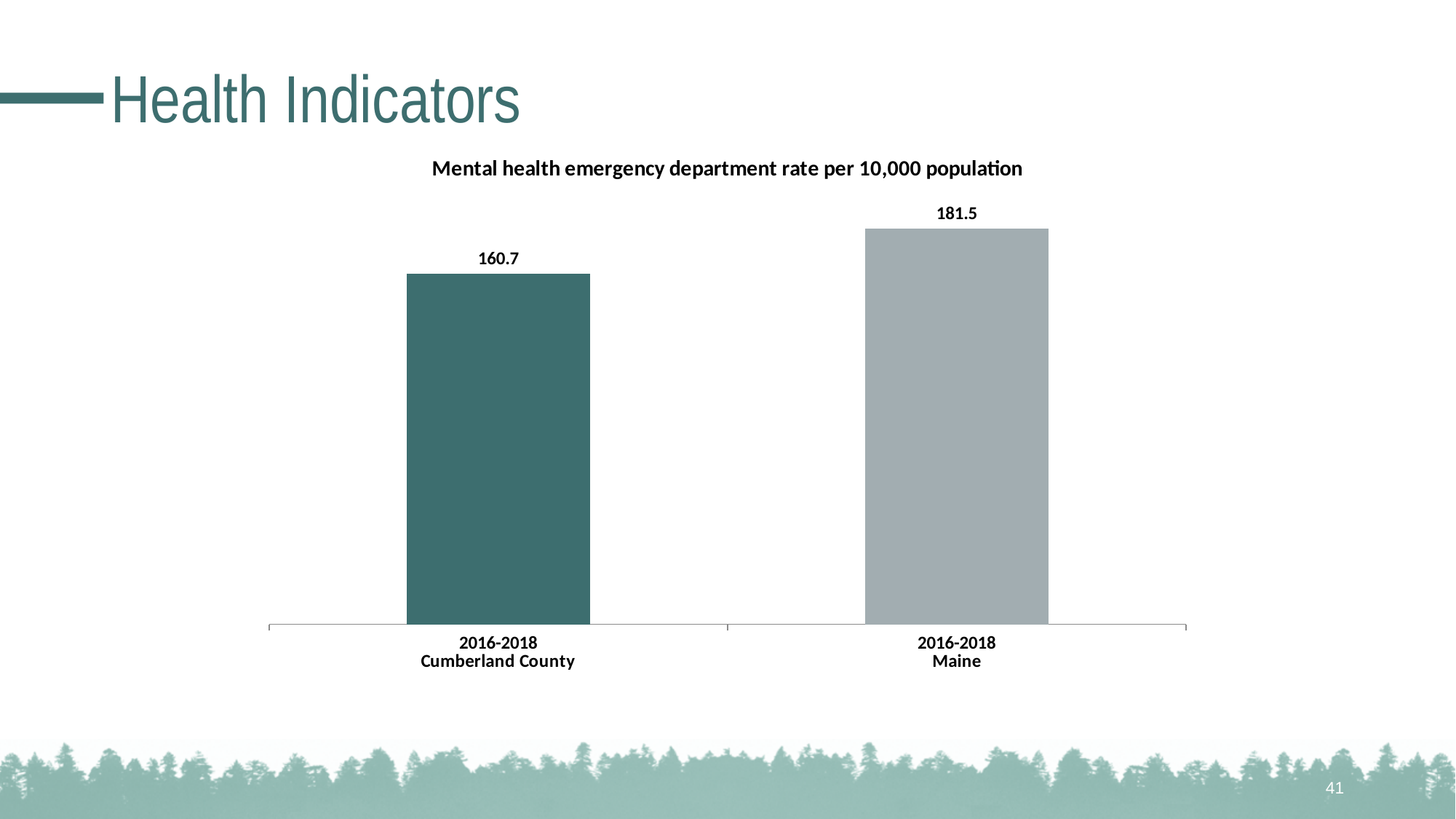
What is the mental health emergency department rate per 10,000 population for Maine (2016-2018)? 181.5 Is the mental health emergency department rate for Cumberland County larger or smaller than the rate for Maine? smaller Which category has the lowest mental health emergency department rate on the chart? Cumberland County Which category has the higher mental health emergency department rate, Cumberland County or Maine? Maine What type of chart is used to show the mental health emergency department rate? bar chart What time period do both bars on the chart cover? 2016-2018 What is the difference between Maine's and Cumberland County's mental health emergency department rates? 20.8 What is the mental health emergency department rate per 10,000 population for Cumberland County (2016-2018)? 160.7 How many bars are shown on the chart? 2 What is the title of the chart on the slide? Mental health emergency department rate per 10,000 population